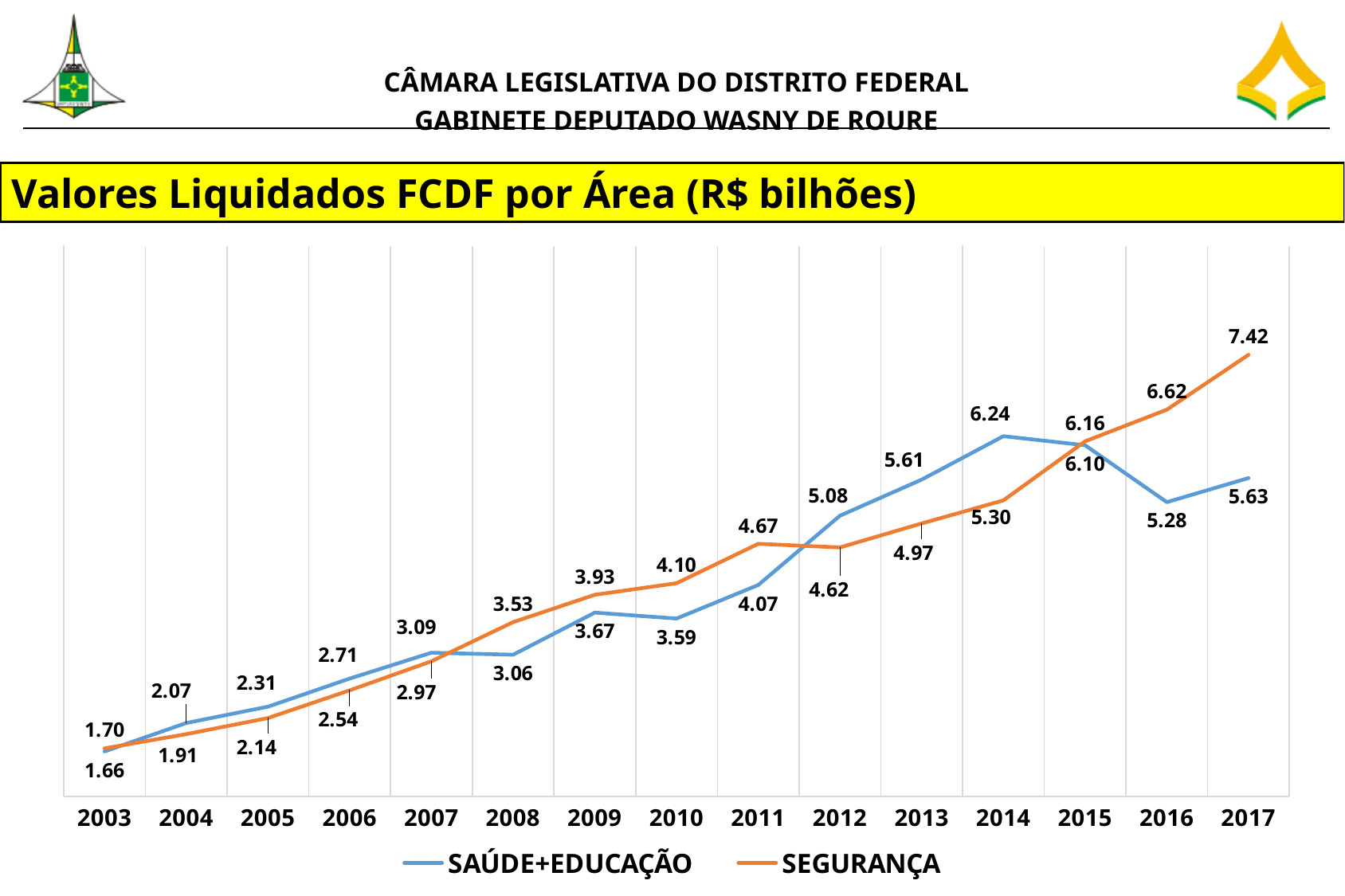
How many series does the legend list? 2 Which series has the larger value in 2012, SAÚDE+EDUCAÇÃO or SEGURANÇA? SAÚDE+EDUCAÇÃO What is the value for SAÚDE+EDUCAÇÃO in 2014? 6.24 What is the difference between SEGURANÇA and SAÚDE+EDUCAÇÃO in 2017? 1.79 What is the value for SEGURANÇA in 2017? 7.42 What kind of chart is shown on the slide? Line chart What is the value for SEGURANÇA in 2010? 4.10 What is the title of the chart? Valores Liquidados FCDF por Área (R$ bilhões) In which year does SAÚDE+EDUCAÇÃO reach its highest value? 2014 What is the value for SAÚDE+EDUCAÇÃO in 2003? 1.66 How many years are shown on the x axis? 15 In which year is the SEGURANÇA value lowest? 2003